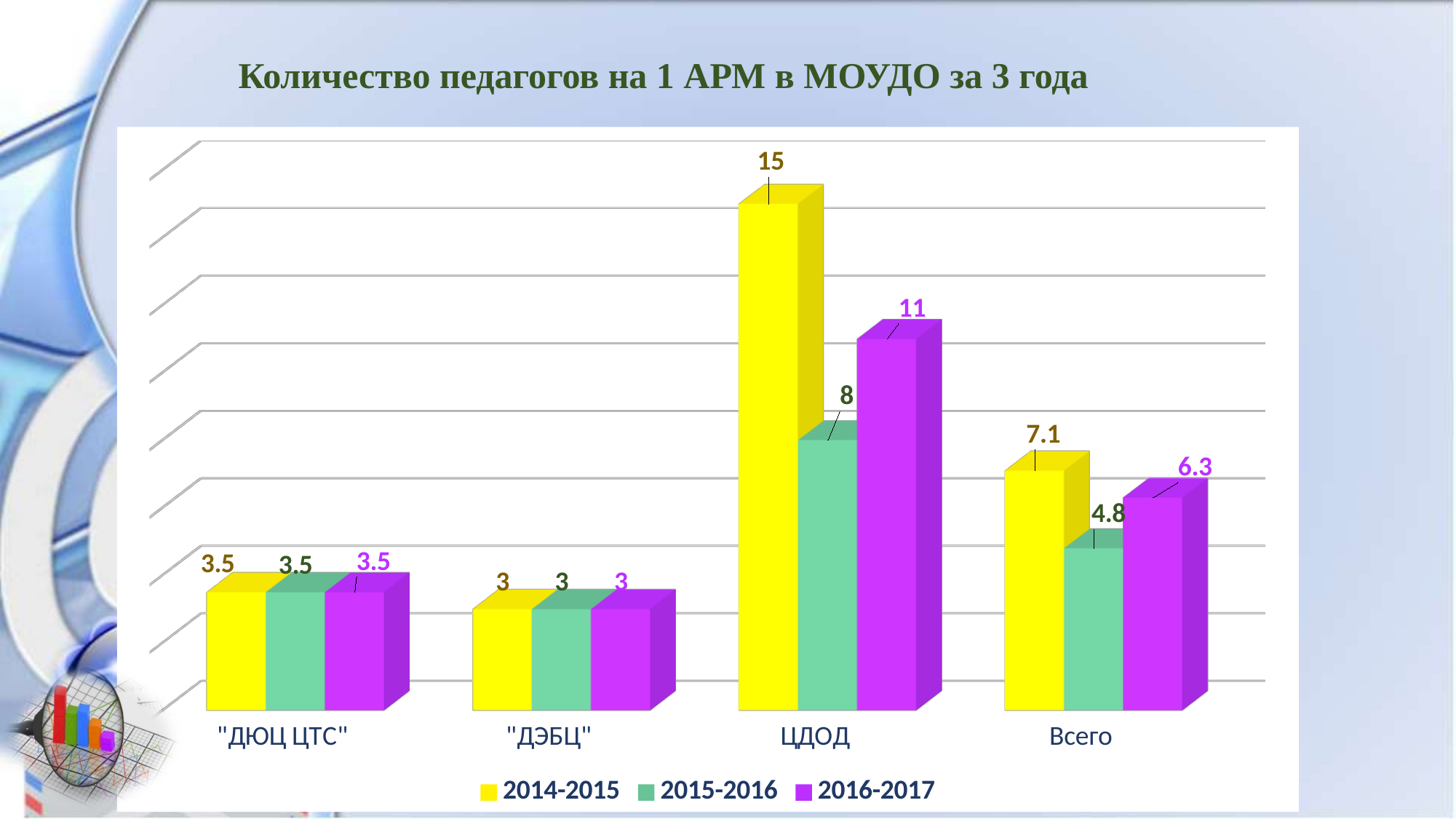
Which category has the lowest value in the 2015-2016 series? "ДЭБЦ" What is the value for ЦДОД in the 2014-2015 series? 15 Which is larger for ЦДОД: the 2015-2016 value or the 2016-2017 value? 2016-2017 What is the difference between the 2014-2015 and 2016-2017 values for Всего? 0.8 Which category has the highest value in the 2016-2017 series? ЦДОД What is the value for "ДЮЦ ЦТС" in the 2014-2015 series? 3.5 What kind of chart is shown on the slide? Bar chart How many categories are shown on the x axis? 4 What is the value for "ДЭБЦ" in the 2016-2017 series? 3 What is the difference between the 2014-2015 and 2015-2016 values for ЦДОД? 7 How many series does the legend list? 3 What is the value for Всего in the 2015-2016 series? 4.8